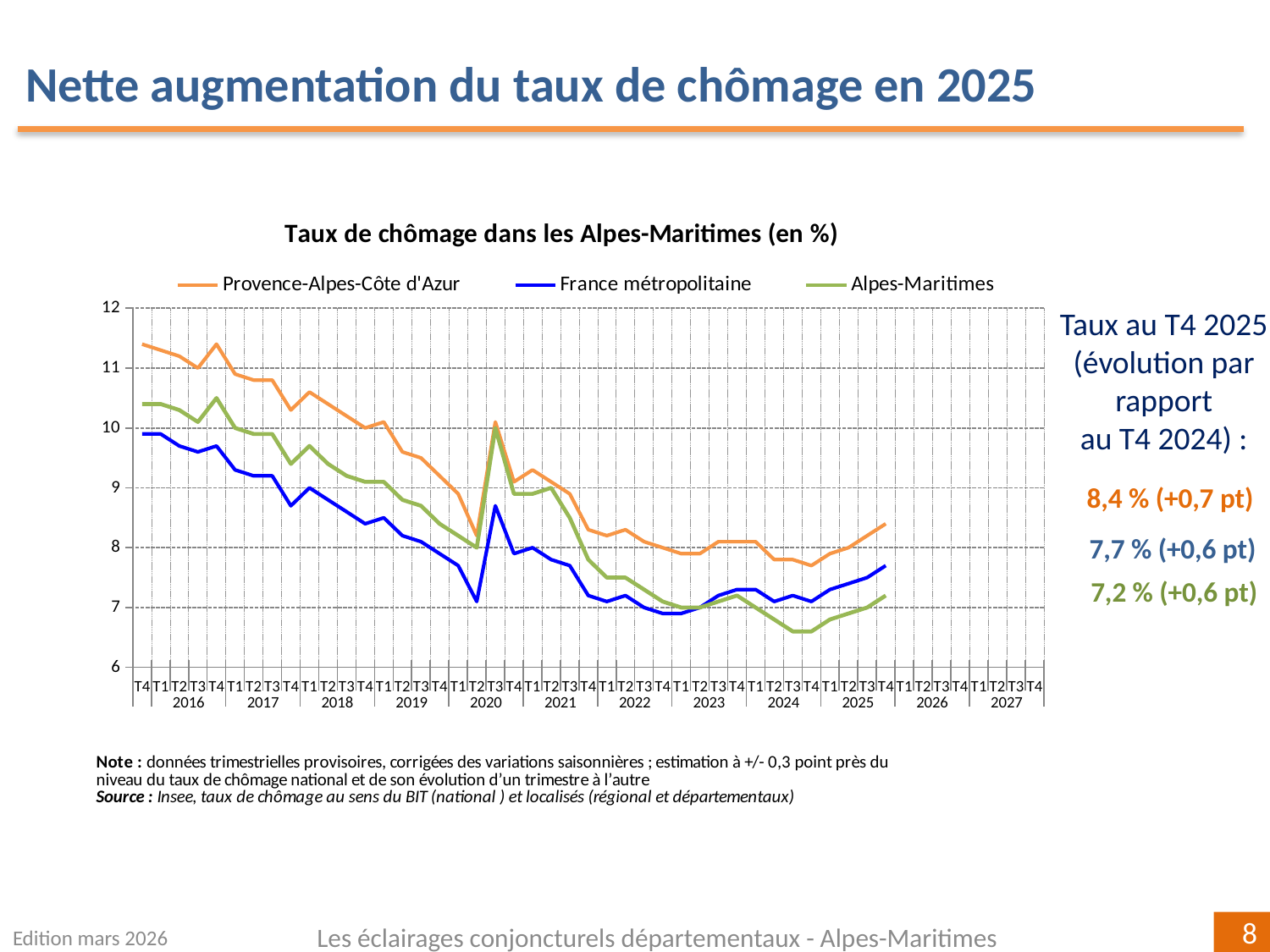
Is the value for Provence-Alpes-Côte d'Azur at T4 2016 greater or less than 11? greater Does the France métropolitaine series rise or fall between T4 2024 and T4 2025? rise What kind of chart is shown on the slide? line chart How many series does the legend of the chart list? 3 What is the unemployment rate for Provence-Alpes-Côte d'Azur at T4 2025? 8,4 % Which series has the highest value at T4 2025? Provence-Alpes-Côte d'Azur By how many points did the Provence-Alpes-Côte d'Azur rate change between T4 2024 and T4 2025? +0,7 pt What is the difference between the Provence-Alpes-Côte d'Azur rate and the Alpes-Maritimes rate at T4 2025? 1,2 points Is the value for Alpes-Maritimes at T4 2024 greater or less than 7? less What is the unemployment rate for France métropolitaine at T4 2025? 7,7 % What is the unemployment rate for Alpes-Maritimes at T4 2025? 7,2 % What is the title of the chart? Taux de chômage dans les Alpes-Maritimes (en %)